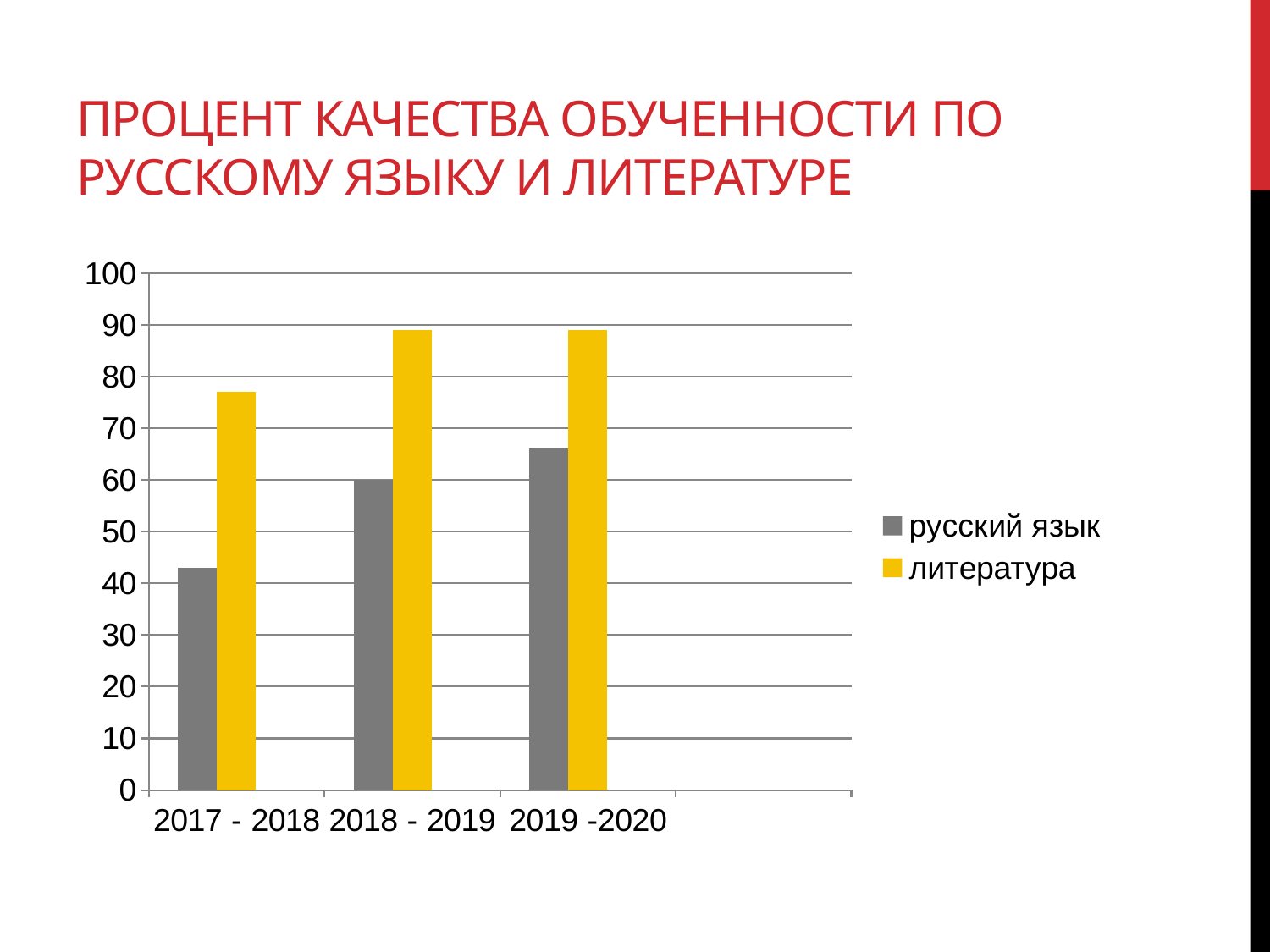
How many academic years are shown on the x axis? 3 Which colour represents литература in the chart? yellow How many series does the legend list? 2 What kind of chart is shown on the slide? bar chart Do the values for русский язык rise or fall from 2017 - 2018 to 2019 -2020? rise Is the value for русский язык in 2019 -2020 greater or less than 70? less In which academic year is the value for русский язык the lowest? 2017 - 2018 Is the value for русский язык in 2017 - 2018 greater or less than 50? less Is the value for литература in 2018 - 2019 greater or less than 80? greater In which academic year is the value for русский язык the highest? 2019 -2020 Which series has the larger value in 2019 -2020, русский язык or литература? литература